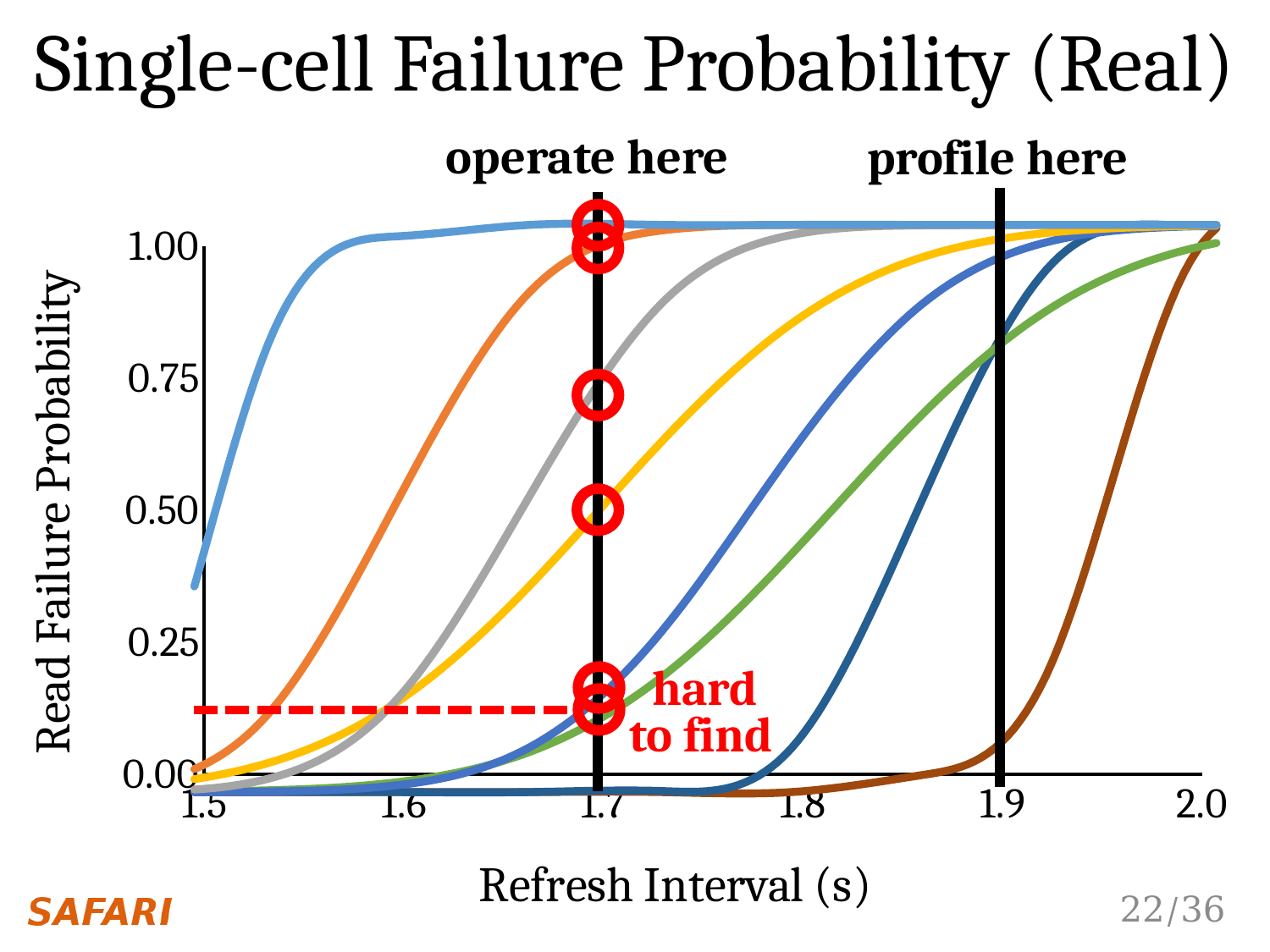
What kind of chart is shown on the slide? line chart Do the curves rise or fall as the refresh interval increases? rise At a refresh interval of 1.9, which curve is higher: the light blue curve or the brown curve? light blue Is the value of the light blue curve at a refresh interval of 1.7 greater or less than 0.75? greater At which refresh interval is the 'profile here' vertical line drawn? 1.9 Is the value of the brown curve at a refresh interval of 1.9 greater or less than 0.25? less What is the highest tick value shown on the x axis? 2.0 Is the value of the green curve at a refresh interval of 1.7 greater or less than 0.25? less What is the title of the slide's chart? Single-cell Failure Probability (Real) At which refresh interval is the 'operate here' vertical line drawn? 1.7 What is the label of the x axis? Refresh Interval (s)